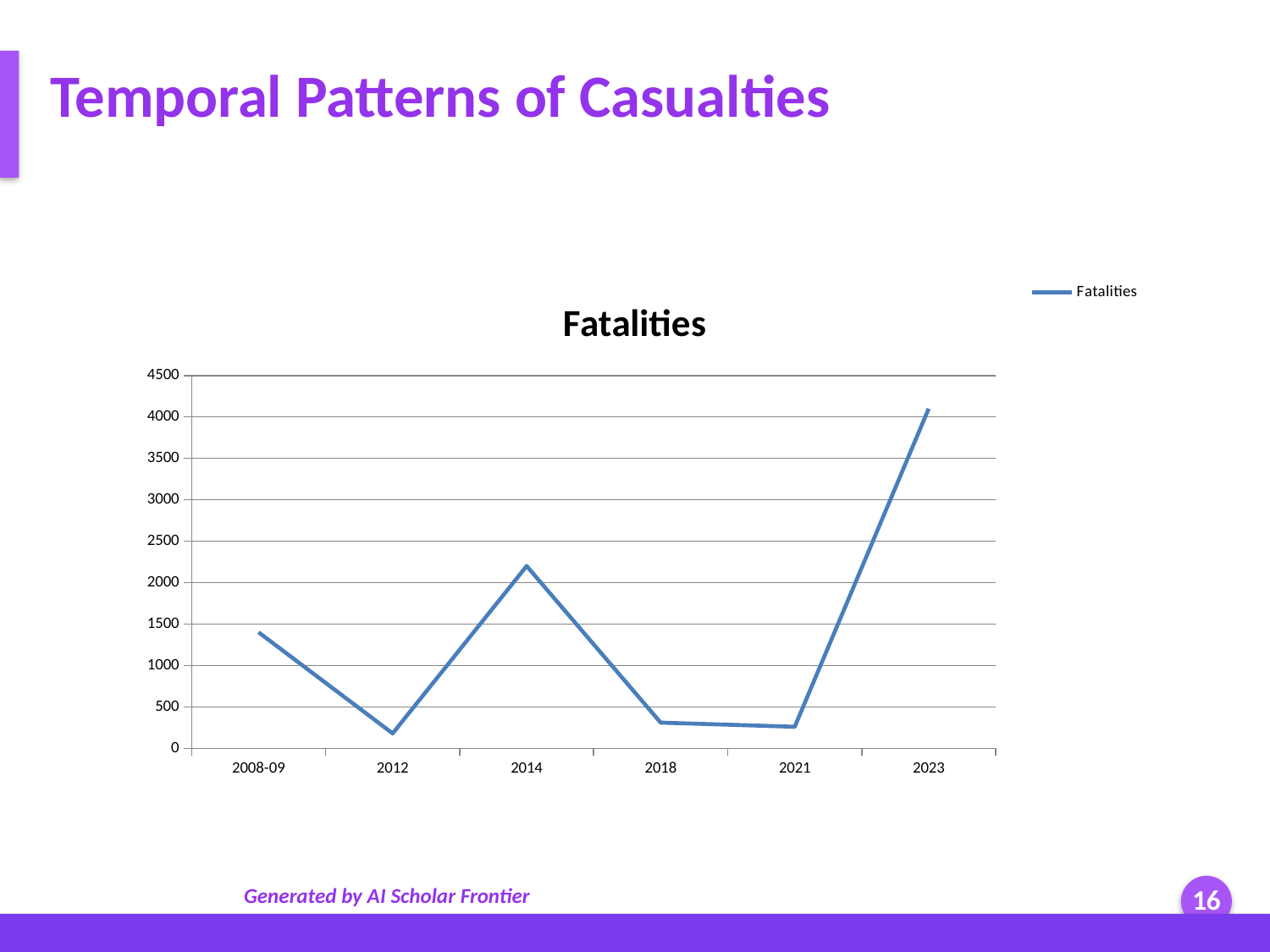
Is the value for 2023 greater or less than 3500? greater How many time points are plotted along the x axis? 6 Do fatalities rise or fall from 2021 to 2023? rise What is the title of the chart? Fatalities How many series does the legend list? 1 Is the value for 2008-09 greater or less than 1000? greater Which time point has the highest number of fatalities? 2023 Which has more fatalities, 2014 or 2008-09? 2014 What kind of chart is shown on the slide? line chart Do fatalities rise or fall from 2008-09 to 2012? fall Is the value for 2012 greater or less than 500? less